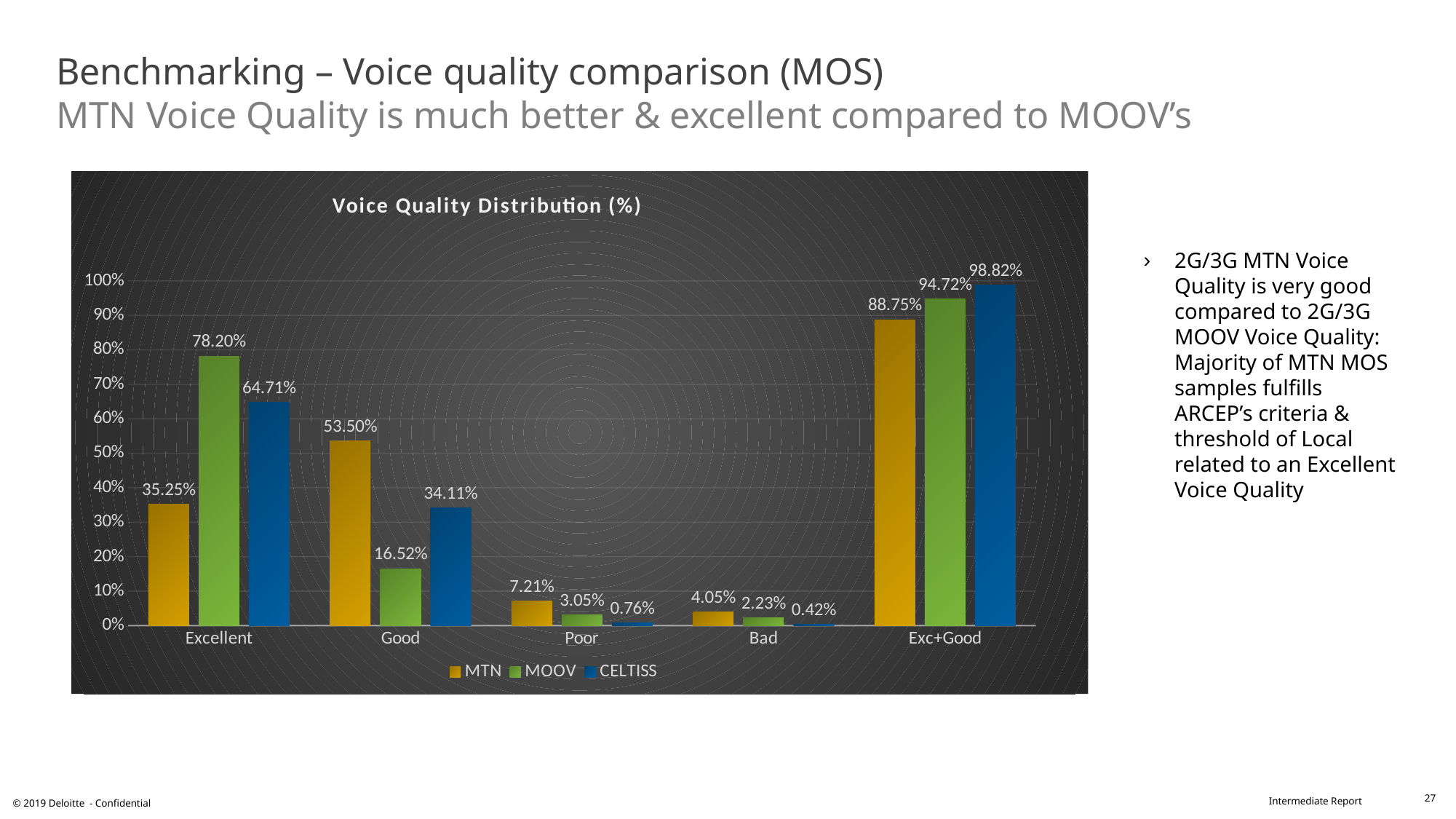
What is the MTN value for the Good category? 53.50% How many series does the legend list? 3 What is the title of the chart? Voice Quality Distribution (%) How many categories are shown on the x axis? 5 Which series has the highest value in the Excellent category? MOOV What is the CELTISS value for the Exc+Good category? 98.82% Which series has the lowest value in the Poor category? CELTISS What is the MOOV value for the Excellent category? 78.20% What is the CELTISS value for the Bad category? 0.42% What kind of chart is shown on the slide? Bar chart Which is larger in the Good category, the MTN value or the CELTISS value? MTN What is the difference between the MOOV and MTN values in the Exc+Good category? 5.97%